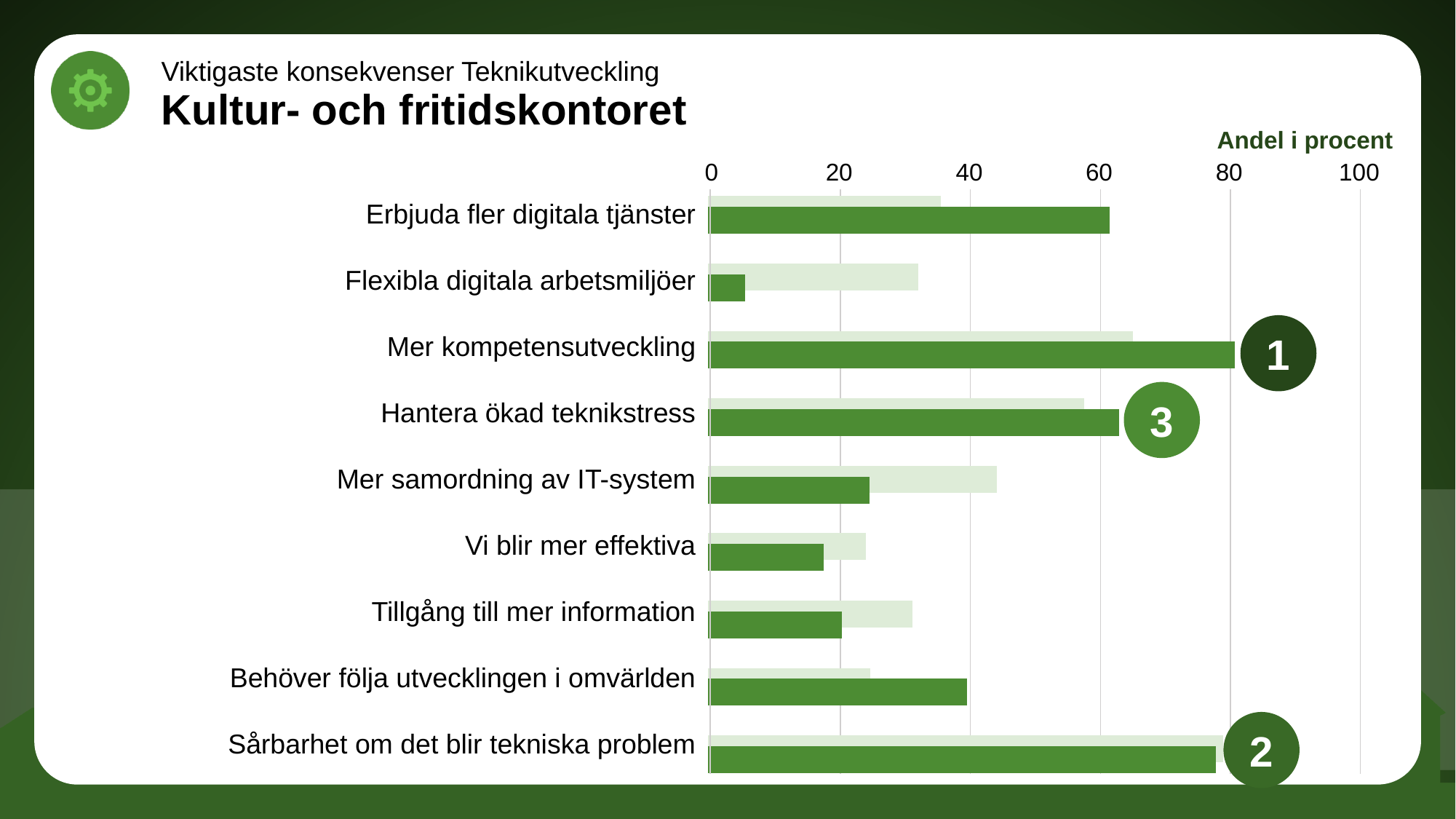
Which category is marked with the circled number 1? Mer kompetensutveckling Which category has the highest light green bar? Sårbarhet om det blir tekniska problem Is the dark green value for Sårbarhet om det blir tekniska problem greater or less than 60? greater How many categories are listed on the chart? 9 Is the dark green value for Flexibla digitala arbetsmiljöer greater or less than 20? less Is the dark green value for Behöver följa utvecklingen i omvärlden greater or less than 60? less What kind of chart is shown on the slide? bar chart Which category has the lowest dark green bar? Flexibla digitala arbetsmiljöer What is the label shown above the horizontal axis of the chart? Andel i procent Which has the larger dark green bar, Mer kompetensutveckling or Vi blir mer effektiva? Mer kompetensutveckling Which has the larger dark green bar, Erbjuda fler digitala tjänster or Flexibla digitala arbetsmiljöer? Erbjuda fler digitala tjänster